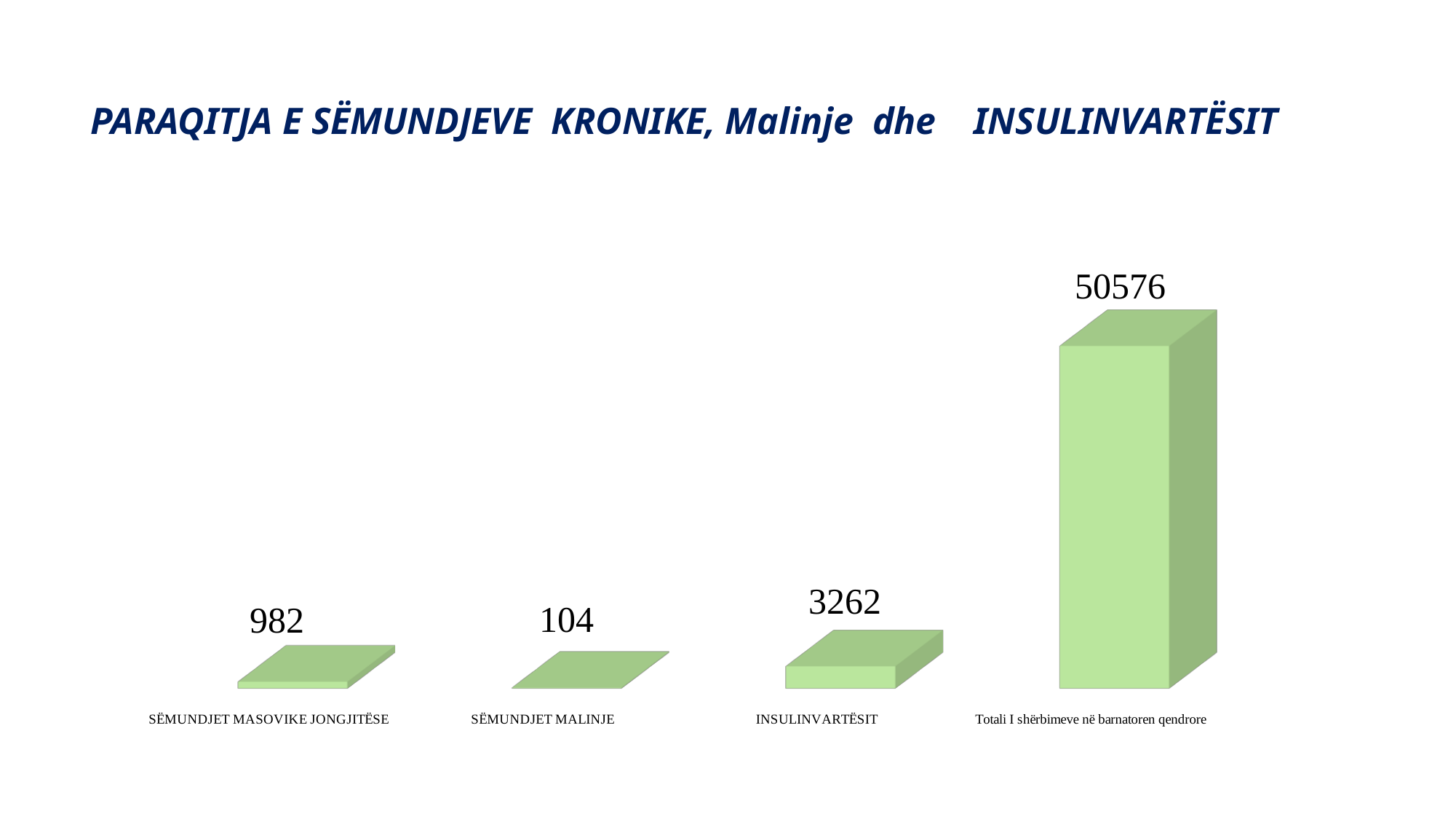
What is the value for Totali I shërbimeve në barnatoren qendrore? 50576 Which is larger, the value for INSULINVARTËSIT or the value for SËMUNDJET MALINJE? INSULINVARTËSIT What is the difference between the values for SËMUNDJET MASOVIKE JONGJITËSE and SËMUNDJET MALINJE? 878 How many categories are shown in the chart? 4 Which category has the lowest value? SËMUNDJET MALINJE What is the value for SËMUNDJET MASOVIKE JONGJITËSE? 982 What is the difference between the values for INSULINVARTËSIT and SËMUNDJET MASOVIKE JONGJITËSE? 2280 What kind of chart is shown on the slide? bar chart What is the title of the slide? PARAQITJA E SËMUNDJEVE KRONIKE, Malinje dhe INSULINVARTËSIT What is the value for SËMUNDJET MALINJE? 104 What is the value for INSULINVARTËSIT? 3262 Which category has the highest value? Totali I shërbimeve në barnatoren qendrore